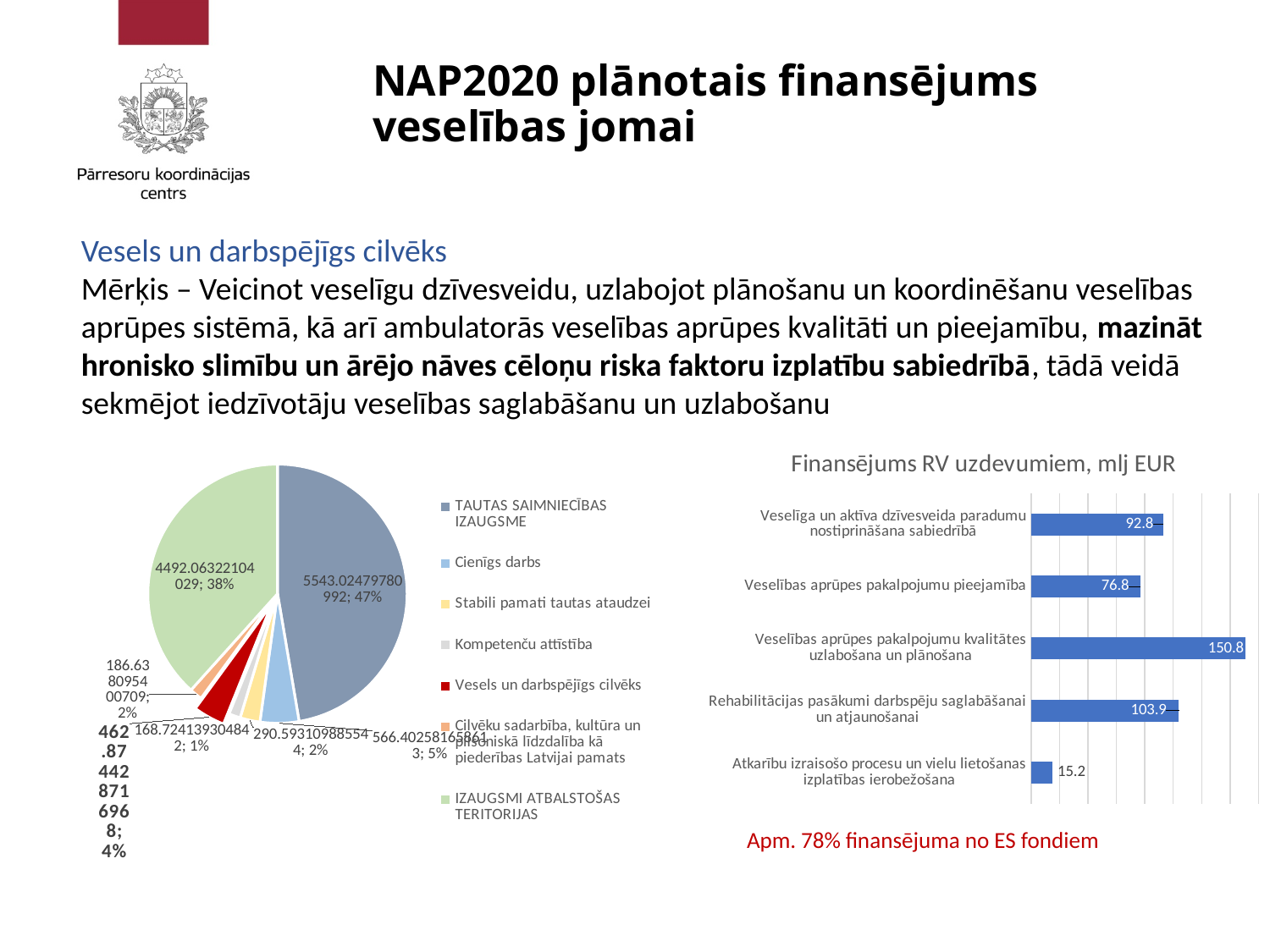
In the bar chart 'Finansējums RV uzdevumiem, mlj EUR', what is the value for 'Veselīga un aktīva dzīvesveida paradumu nostiprināšana sabiedrībā'? 92.8 In the bar chart 'Finansējums RV uzdevumiem, mlj EUR', which category has the lowest value? Atkarību izraisošo procesu un vielu lietošanas izplatības ierobežošana What kind of chart is the chart titled 'Finansējums RV uzdevumiem, mlj EUR'? bar chart In the pie chart on the left, what share does the 'IZAUGSMI ATBALSTOŠAS TERITORIJAS' slice have? 38% How many entries does the legend of the pie chart on the left list? 7 How many categories are shown in the bar chart 'Finansējums RV uzdevumiem, mlj EUR'? 5 In the bar chart 'Finansējums RV uzdevumiem, mlj EUR', which is larger: the value for 'Veselīga un aktīva dzīvesveida paradumu nostiprināšana sabiedrībā' or for 'Veselības aprūpes pakalpojumu pieejamība'? Veselīga un aktīva dzīvesveida paradumu nostiprināšana sabiedrībā In the bar chart 'Finansējums RV uzdevumiem, mlj EUR', what is the difference between the values for 'Veselības aprūpes pakalpojumu kvalitātes uzlabošana un plānošana' and 'Rehabilitācijas pasākumi darbspēju saglabāšanai un atjaunošanai'? 46.9 What kind of chart is the chart on the left side of the slide? pie chart In the bar chart 'Finansējums RV uzdevumiem, mlj EUR', which category has the highest value? Veselības aprūpes pakalpojumu kvalitātes uzlabošana un plānošana In the bar chart 'Finansējums RV uzdevumiem, mlj EUR', what is the value for 'Rehabilitācijas pasākumi darbspēju saglabāšanai un atjaunošanai'? 103.9 In the pie chart on the left, what share does the 'TAUTAS SAIMNIECĪBAS IZAUGSME' slice have? 47%